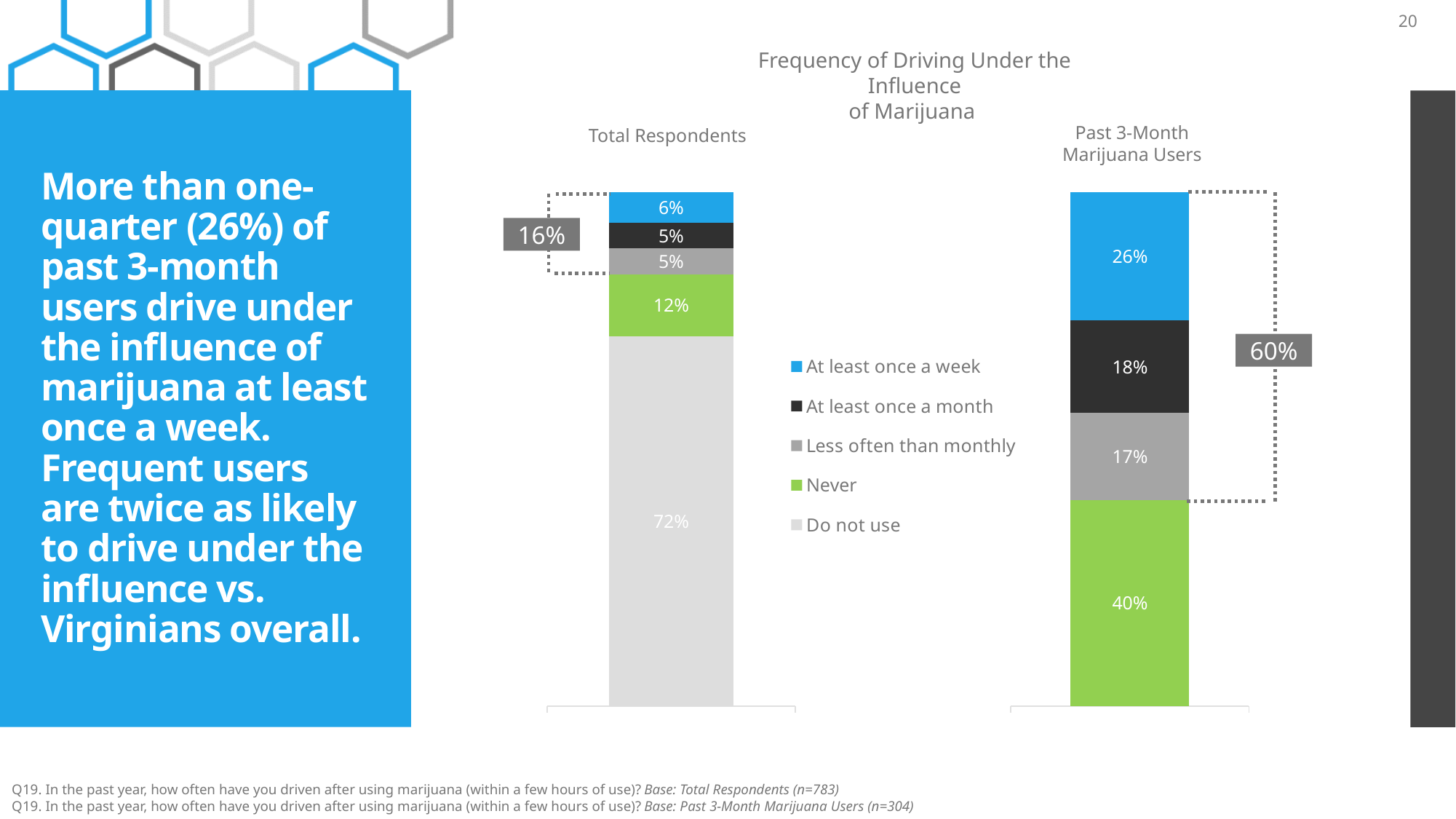
In the Total Respondents chart, what percentage falls in the 'Do not use' category? 72% What type of chart is used on this slide? Stacked bar chart In the Past 3-Month Marijuana Users chart, what percentage drive under the influence at least once a week? 26% In the Total Respondents chart, which category has the largest share? Do not use What is the combined share of the top three segments (at least once a week, at least once a month, less often than monthly) in the Past 3-Month Marijuana Users chart, as shown by the callout? 60% In the Past 3-Month Marijuana Users chart, which category has the largest share? Never In the Total Respondents chart, what percentage of respondents drive under the influence of marijuana at least once a week? 6% What is the difference between the 'At least once a week' share for Past 3-Month Marijuana Users and for Total Respondents? 20 percentage points In the Past 3-Month Marijuana Users chart, what percentage answered 'Never'? 40% Which is larger: the 'At least once a month' share for Past 3-Month Marijuana Users or for Total Respondents? Past 3-Month Marijuana Users How many categories does the legend list? 5 What is the combined share of the top three segments in the Total Respondents chart, as shown by the callout? 16%